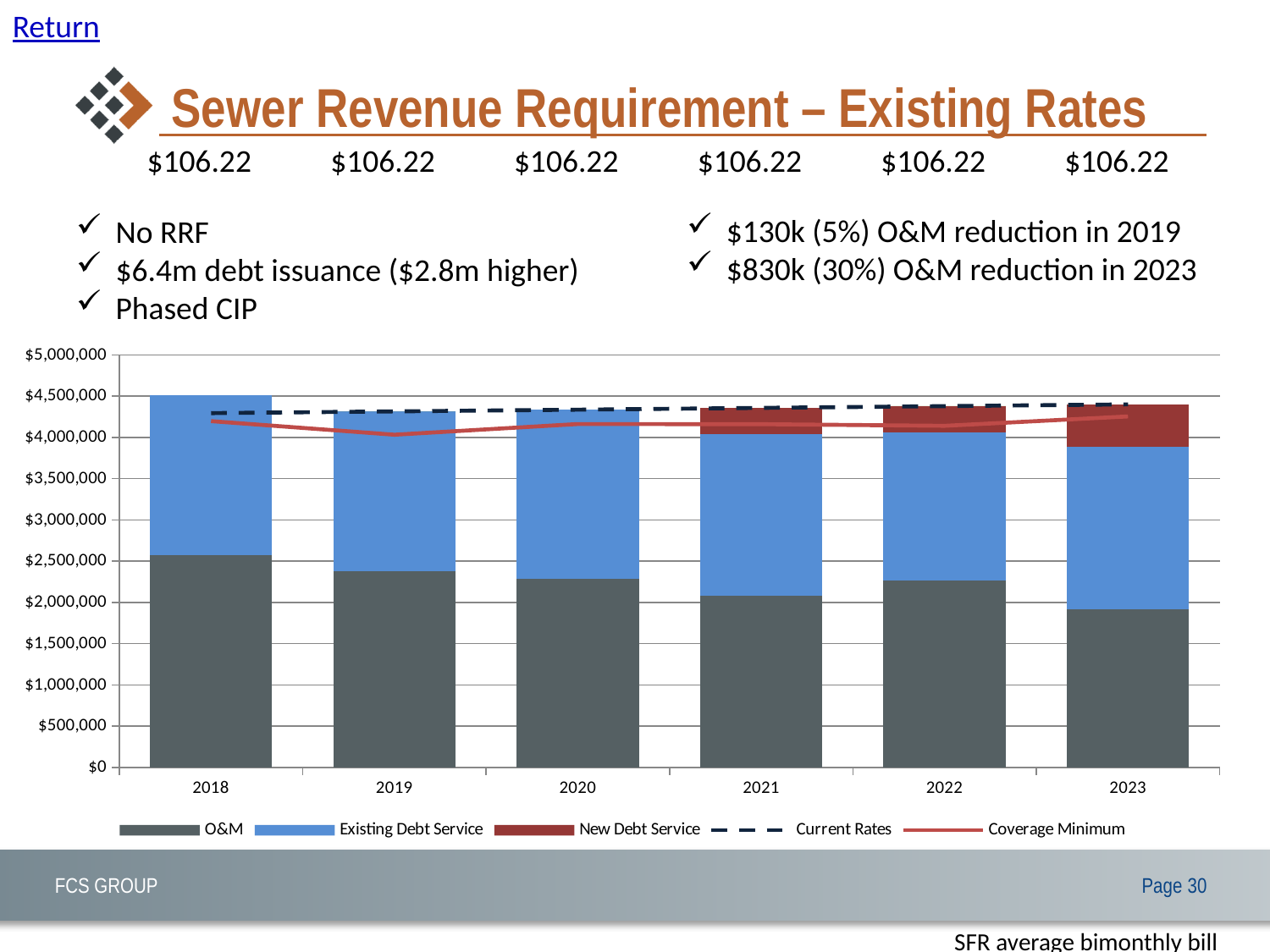
Which year has the lowest O&M value? 2023 Is the O&M value for 2019 greater or less than $2,500,000? less In how many years does the New Debt Service segment appear in the bars? 3 How many years are shown on the x axis of the chart? 6 Which is larger, the O&M value for 2018 or for 2023? 2018 How many series does the chart legend list? 5 What kind of chart is shown on the slide? Stacked bar chart with line series Is the O&M value for 2023 greater or less than $2,000,000? less Which year has the highest O&M value? 2018 Does the O&M value rise or fall from 2018 to 2021? Fall Is the total stacked bar for 2023 greater or less than $4,500,000? less Which series is drawn as a dashed line in the chart? Current Rates